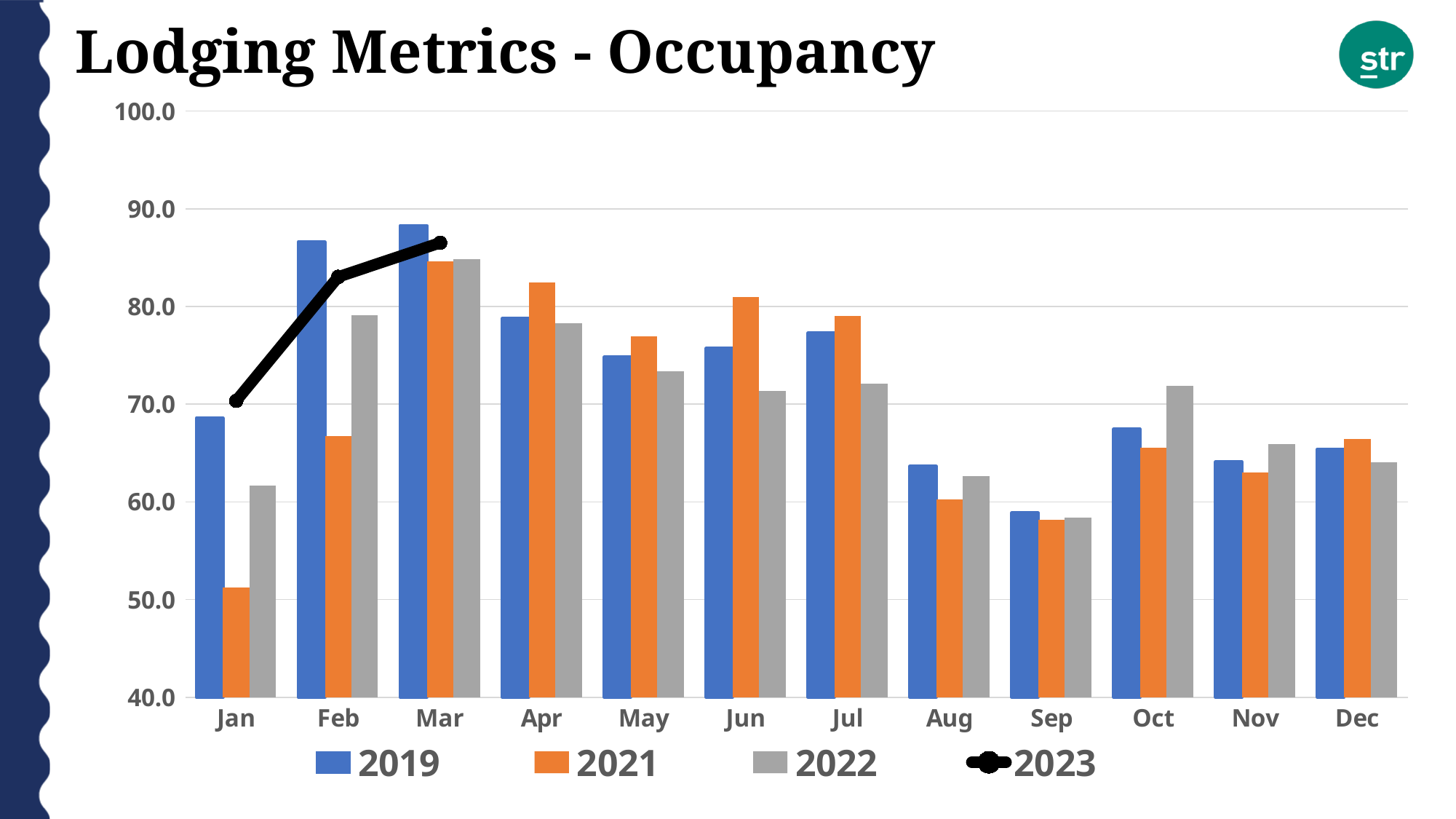
How many series does the legend list? 4 In which month is the 2019 occupancy highest? Mar What kind of chart is shown on the slide? bar chart (with a line for 2023) Is the 2019 value for Feb greater or less than 80.0? greater How many months are shown along the x axis? 12 In Jun, which is larger: the 2021 value or the 2022 value? 2021 Is the 2021 value for Jan greater or less than 60.0? less In which month is the 2021 occupancy lowest? Jan Is the 2022 value for Oct greater or less than 70.0? greater Does the 2023 line rise or fall from Jan to Mar? rises What colour represents 2022 in the legend? grey In which month is the 2019 occupancy lowest? Sep